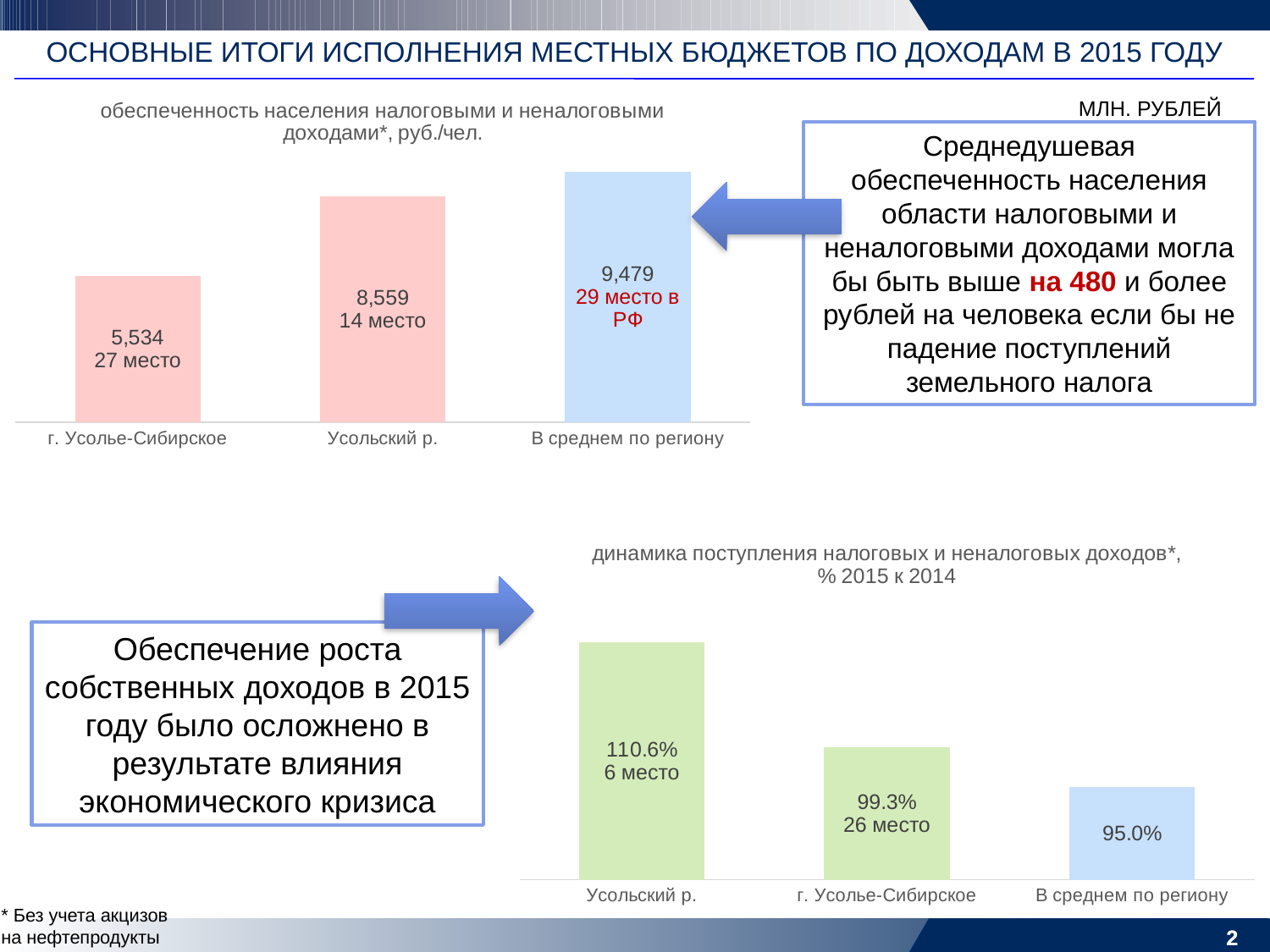
What kind of chart is the bottom chart? bar chart In the top chart, what is the value for г. Усолье-Сибирское? 5,534 In the bottom chart, what is the difference between the value for Усольский р. and the value for г. Усолье-Сибирское? 11.3% In the bottom chart, do the values rise or fall from left to right? fall In the top chart, what is the difference between the value for В среднем по региону and the value for г. Усолье-Сибирское? 3,945 In the bottom chart, what is the value for Усольский р.? 110.6% In the top chart, which category has the lowest value? г. Усолье-Сибирское In the bottom chart, what is the value for В среднем по региону? 95.0% In the bottom chart, which category has the lowest value? В среднем по региону In the top chart, how many categories are shown? 3 In the top chart, what is the value for Усольский р.? 8,559 In the top chart, which category has the highest value? В среднем по региону